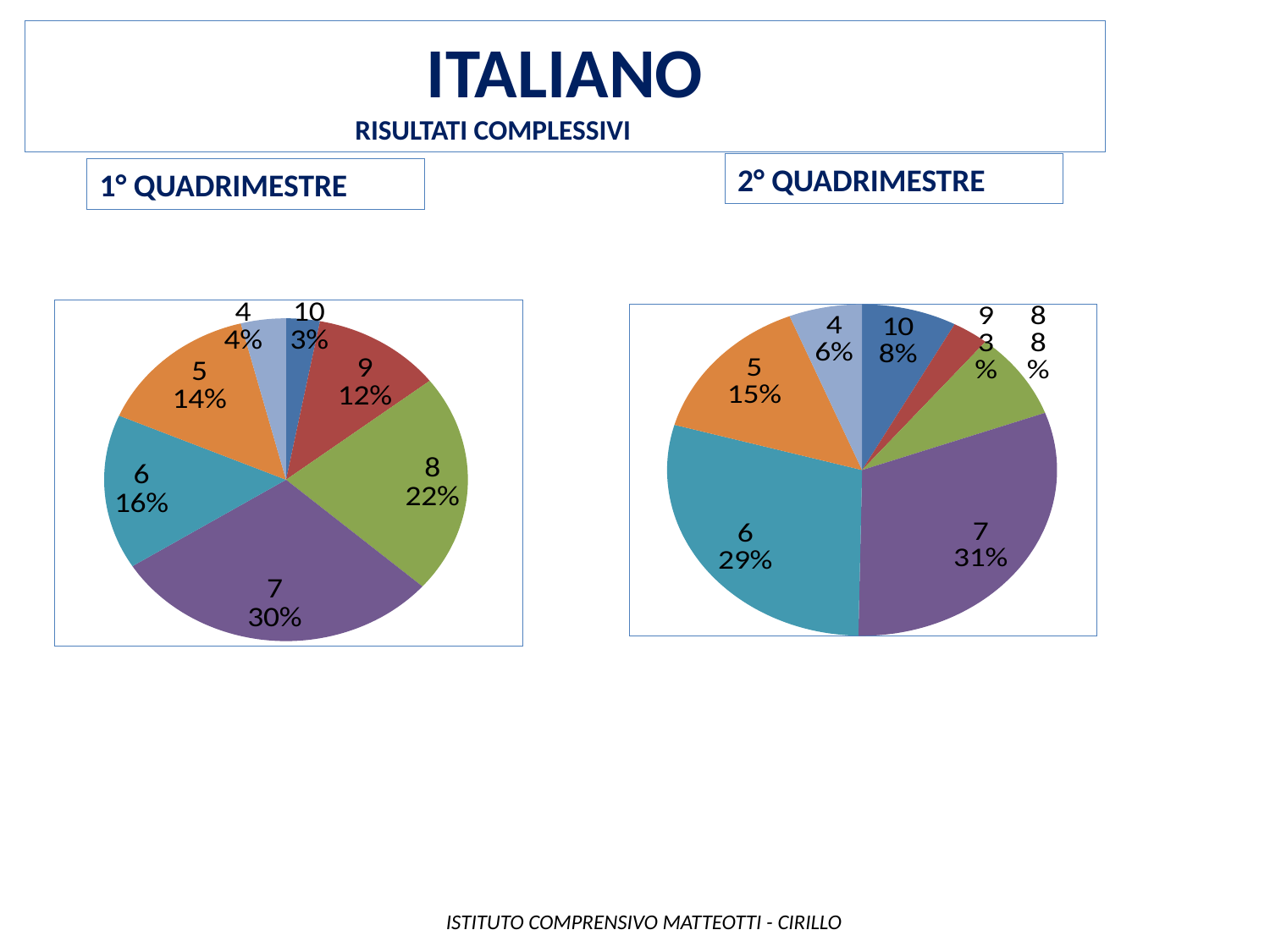
In the 2° QUADRIMESTRE pie chart, what share does grade 5 have? 15% In the 2° QUADRIMESTRE pie chart, what share does grade 6 have? 29% In the 1° QUADRIMESTRE pie chart, which grade has the smallest share? 10 Which is larger: the share of grade 6 in the 1° QUADRIMESTRE chart or in the 2° QUADRIMESTRE chart? 2° QUADRIMESTRE In the 1° QUADRIMESTRE pie chart, what share does grade 8 have? 22% In the 1° QUADRIMESTRE pie chart, how many slices are there? 7 What type of chart is used for the 1° QUADRIMESTRE results? Pie chart In the 2° QUADRIMESTRE pie chart, what is the difference between the shares of grade 7 and grade 6? 2% In the 2° QUADRIMESTRE pie chart, which grade has the smallest share? 9 In the 1° QUADRIMESTRE pie chart, which grade has the largest share? 7 In the 2° QUADRIMESTRE pie chart, which grade has the largest share? 7